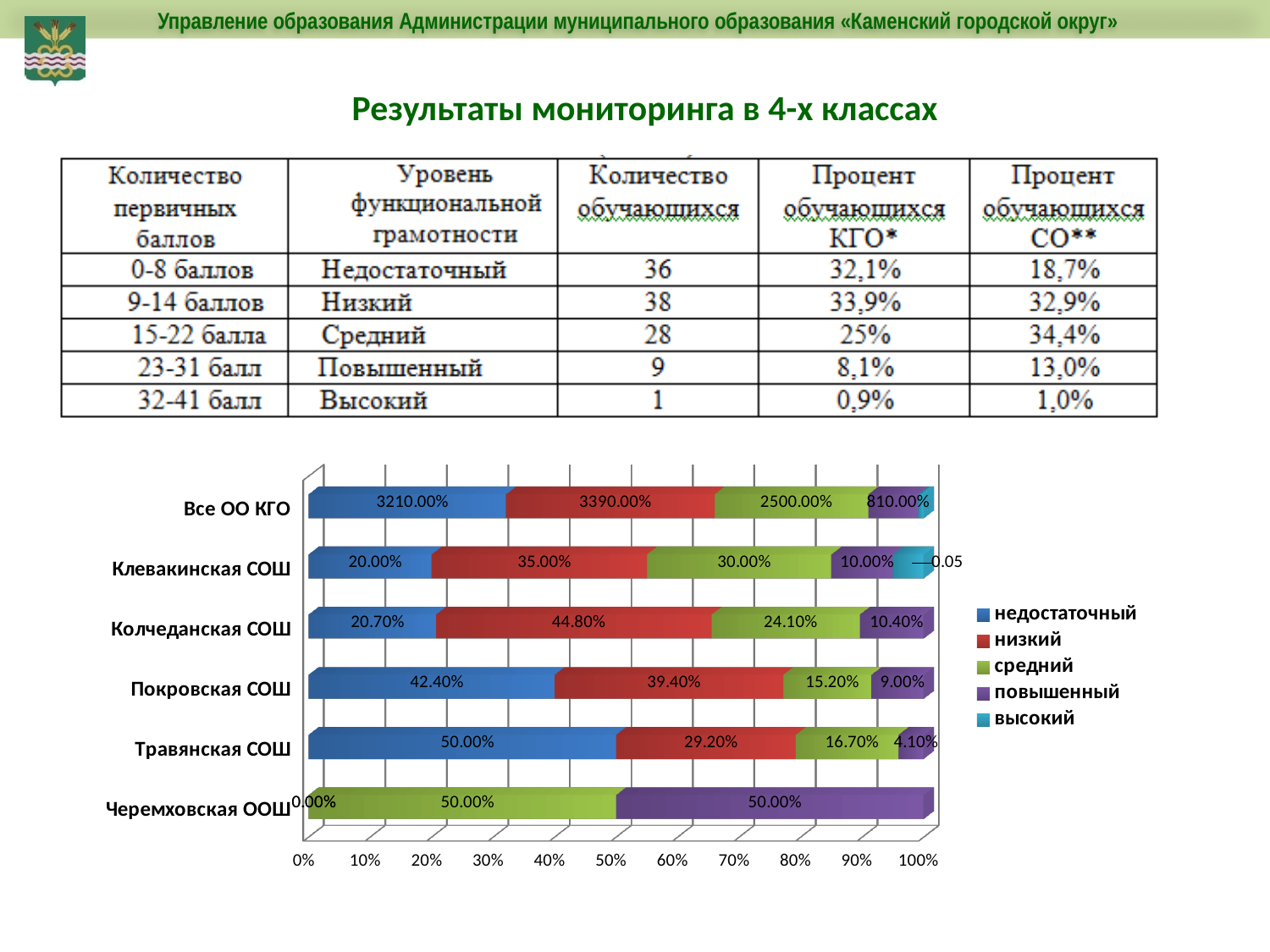
Which is larger for Клевакинская СОШ: the 'низкий' value or the 'средний' value? низкий What is the value of the 'недостаточный' series for Травянская СОШ? 50.00% How many categories (rows) are plotted in the chart? 6 What is the value of the 'высокий' series for Клевакинская СОШ? 0.05 What is the value of the 'повышенный' series for Черемховская ООШ? 50.00% What is the value of the 'средний' series for Покровская СОШ? 15.20% What is the difference between the 'недостаточный' and 'низкий' values for Покровская СОШ? 3.00% What is the value of the 'низкий' series for Колчеданская СОШ? 44.80% What kind of chart is shown on the slide? bar chart How many series does the chart legend list? 5 Which school has the highest value for the 'недостаточный' series? Травянская СОШ Which school has the lowest value for the 'повышенный' series? Травянская СОШ